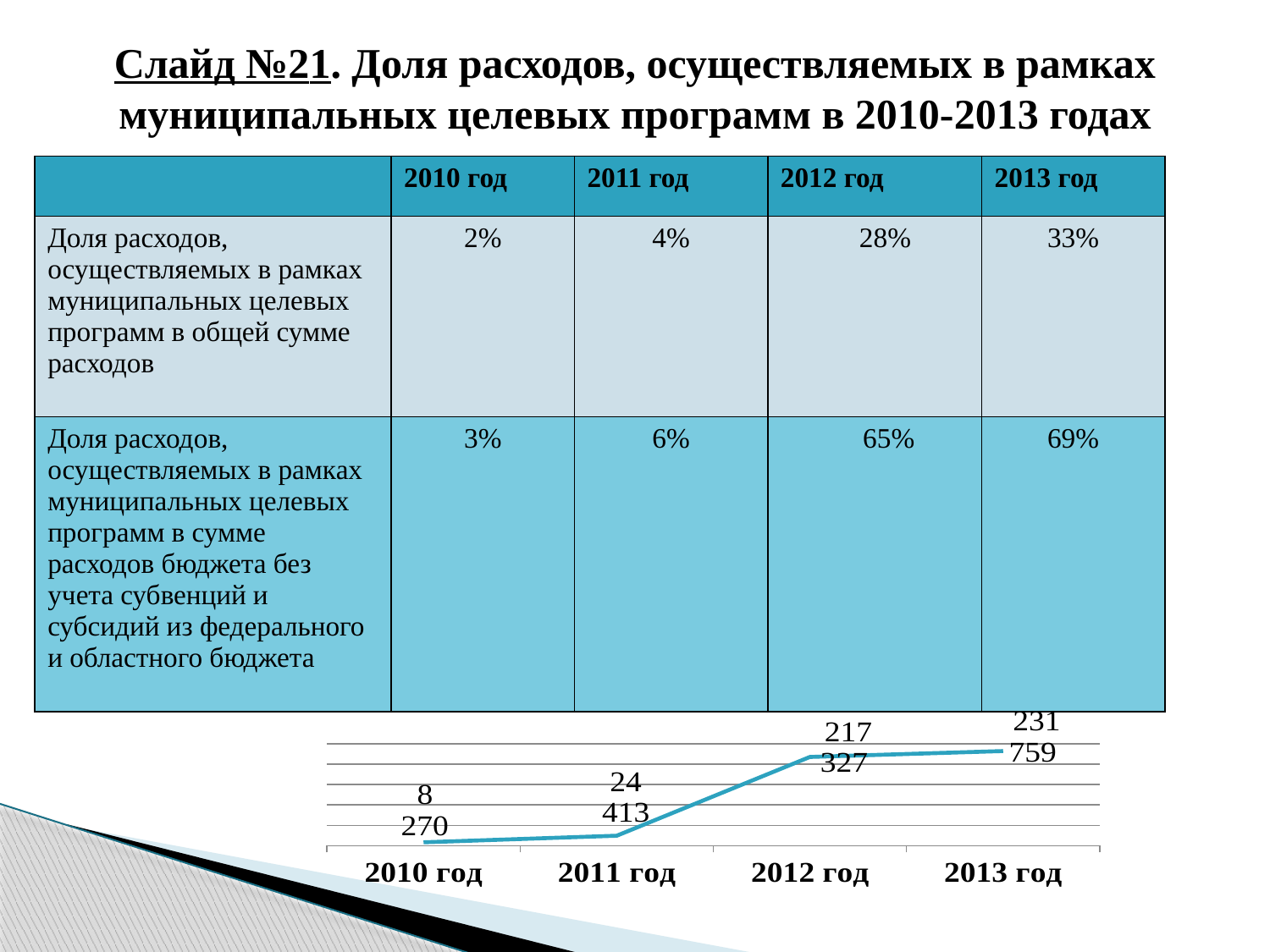
Which year has the lowest value on the line chart? 2010 год Which year has the highest value on the line chart? 2013 год How many points (years) are plotted on the line chart? 4 Do the values on the line chart rise or fall from 2010 год to 2013 год? rise What is the value plotted for 2012 год on the line chart? 217 327 On the line chart, which is larger: the value for 2011 год or the value for 2012 год? 2012 год What is the value plotted for 2013 год on the line chart? 231 759 On the line chart, what is the difference between the values for 2013 год and 2012 год? 14 432 What kind of chart is shown at the bottom of the slide? line chart What is the value plotted for 2011 год on the line chart? 24 413 What are the category labels on the x axis of the line chart? 2010 год, 2011 год, 2012 год, 2013 год What is the value plotted for 2010 год on the line chart? 8 270